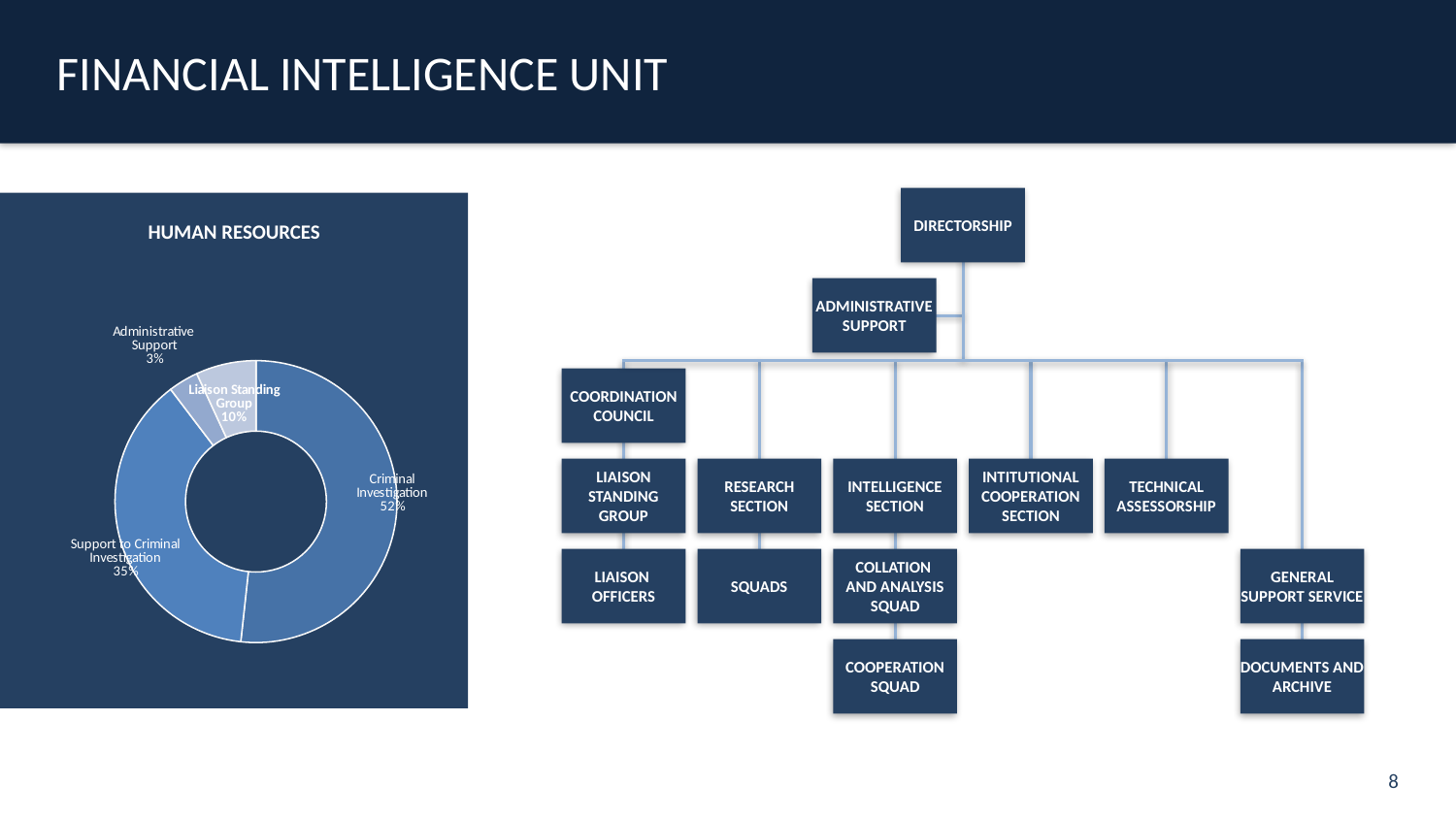
What kind of chart is shown under the title HUMAN RESOURCES? Doughnut chart In the HUMAN RESOURCES chart, which is larger: Liaison Standing Group or Administrative Support? Liaison Standing Group In the HUMAN RESOURCES chart, what share is Criminal Investigation? 52% In the HUMAN RESOURCES chart, what share is Liaison Standing Group? 10% How many categories are shown in the HUMAN RESOURCES chart? 4 In the HUMAN RESOURCES chart, what is the difference in percentage points between Criminal Investigation and Support to Criminal Investigation? 17 In the HUMAN RESOURCES chart, what share is Support to Criminal Investigation? 35% In the HUMAN RESOURCES chart, what share is Administrative Support? 3% Which category has the smallest share in the HUMAN RESOURCES chart? Administrative Support In the HUMAN RESOURCES chart, what is the combined share of Liaison Standing Group and Administrative Support? 13% Which category has the largest share in the HUMAN RESOURCES chart? Criminal Investigation What is the title of the chart on the left side of the slide? HUMAN RESOURCES